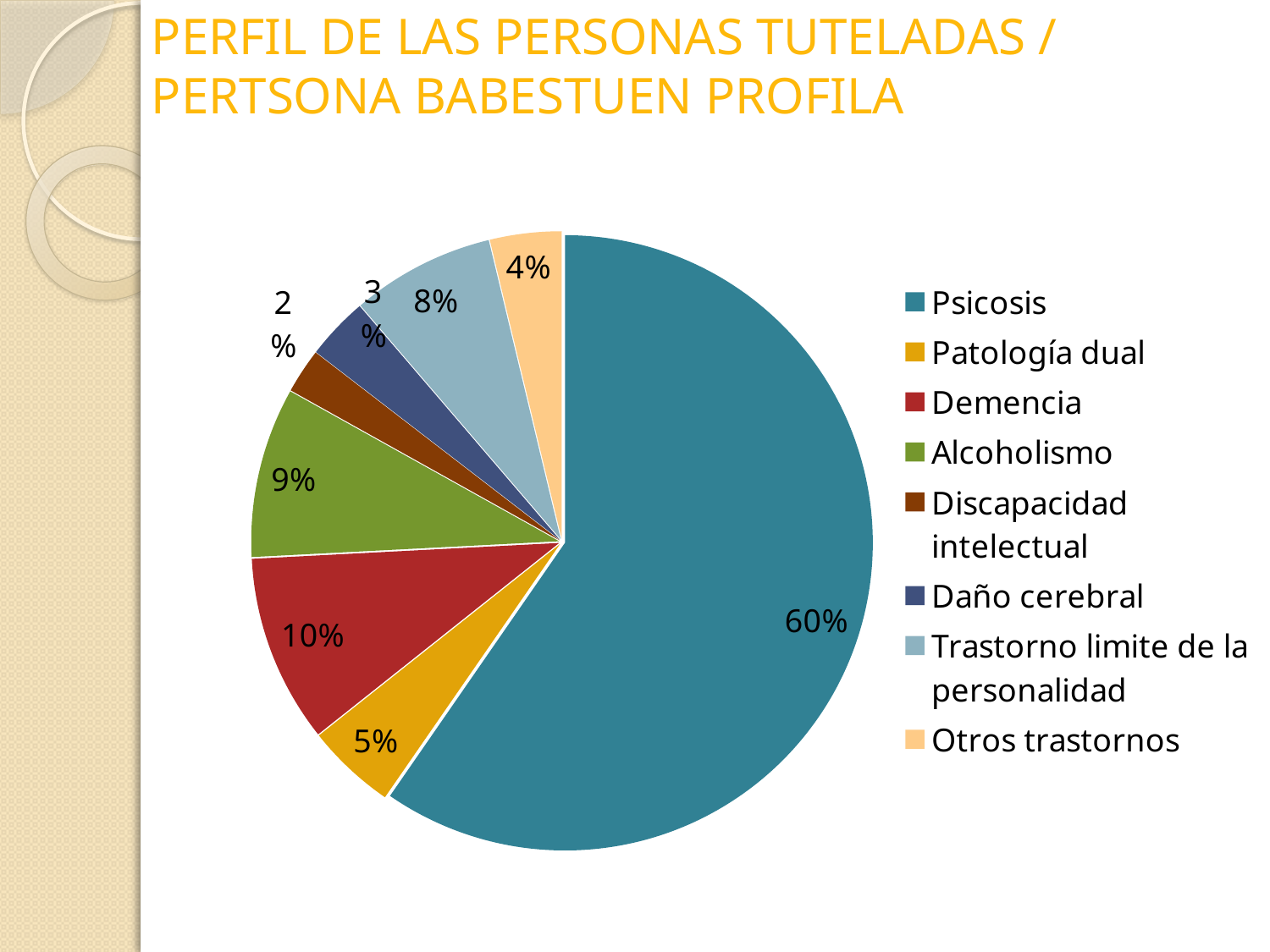
What percentage of the pie is Alcoholismo? 9% Which category has the smallest share of the pie? Discapacidad intelectual Which category has the largest share of the pie? Psicosis What is the title of the slide containing the chart? PERFIL DE LAS PERSONAS TUTELADAS / PERTSONA BABESTUEN PROFILA What kind of chart is shown on the slide? Pie chart What percentage of the pie is Demencia? 10% What percentage of the pie is Psicosis? 60% How many categories does the legend list? 8 What percentage of the pie is Otros trastornos? 4% What is the difference in percentage points between Demencia and Patología dual? 5 What percentage of the pie is Trastorno limite de la personalidad? 8% Which is larger, the share for Alcoholismo or the share for Trastorno limite de la personalidad? Alcoholismo